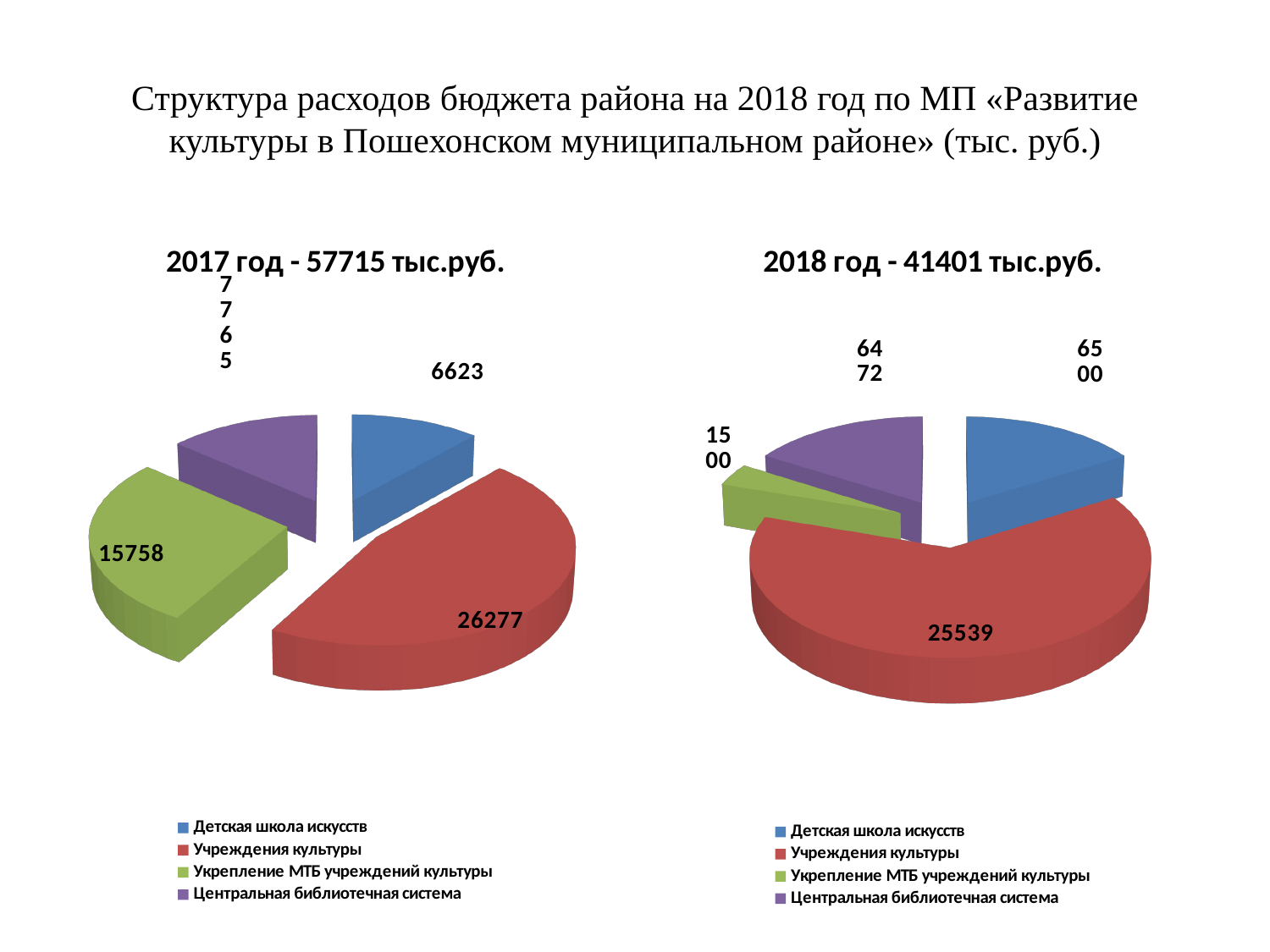
In the left chart (2017 год), what is the value for Укрепление МТБ учреждений культуры? 15758 What is the title of the right chart? 2018 год - 41401 тыс.руб. In the right chart (2018 год), what is the value for Учреждения культуры? 25539 In the left chart (2017 год), what is the value for Учреждения культуры? 26277 In the right chart (2018 год), which is larger: Учреждения культуры or Детская школа искусств? Учреждения культуры In the left chart (2017 год), what is the difference between the values for Учреждения культуры and Укрепление МТБ учреждений культуры? 10519 In the left chart (2017 год), what is the value for Детская школа искусств? 6623 In the right chart (2018 год), which category has the smallest slice? Укрепление МТБ учреждений культуры What kind of chart is the left chart titled "2017 год - 57715 тыс.руб."? pie chart In the right chart (2018 год), which category has the largest slice? Учреждения культуры In the left chart (2017 год), which category has the largest slice? Учреждения культуры How many slices does the left chart (2017 год) have? 4